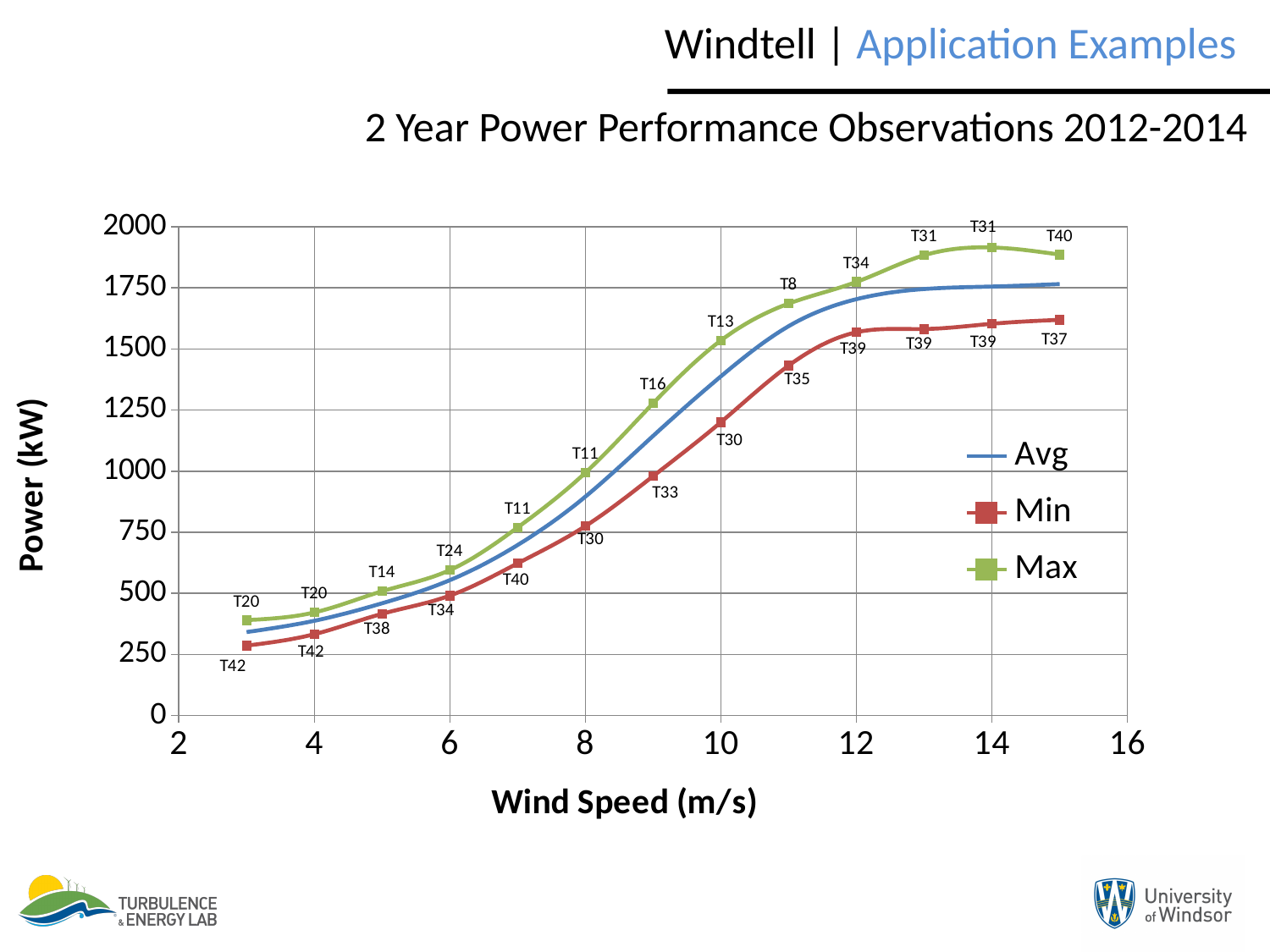
Is the Max value at 11 m/s greater or less than 1750? less At which wind speed is the Min series lowest? 3 m/s How many series does the legend list? 3 Which series are listed in the legend? Avg, Min, Max Is the Max value at 14 m/s greater or less than 1750? greater How many data points does the Min series have? 13 Does the Avg series rise or fall as wind speed increases from 3 to 12 m/s? rise What turbine label is printed on the Max series point at 11 m/s? T8 What kind of chart is shown on the slide? line chart Is the Min value at 3 m/s greater or less than 250? greater At 10 m/s, which series has the larger value, Max or Min? Max